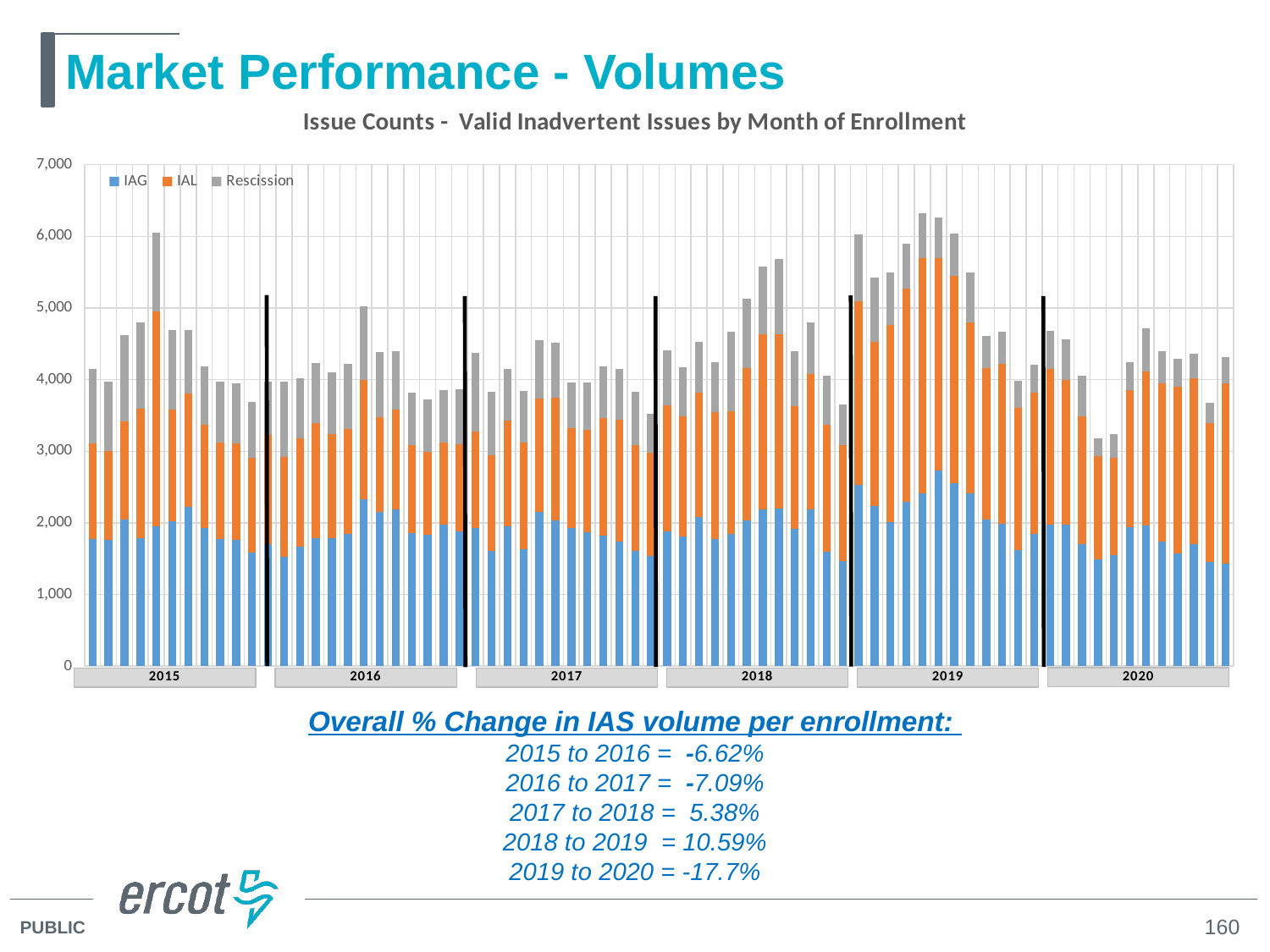
How many series does the chart legend list? 3 What is the title of the chart? Issue Counts - Valid Inadvertent Issues by Month of Enrollment In which year does the tallest stacked bar on the chart appear? 2019 Is the tallest bar in 2015 greater or less than 5,000? greater Is the shortest bar in 2020 greater or less than 3,500? less What kind of chart is shown on the slide? Stacked bar chart Is the tallest bar in 2020 greater or less than 5,000? less What are the three series named in the chart legend? IAG, IAL, Rescission In which year does the shortest stacked bar on the chart appear? 2020 How many years are labelled along the x axis of the chart? 6 Which year has the taller peak bar, 2018 or 2019? 2019